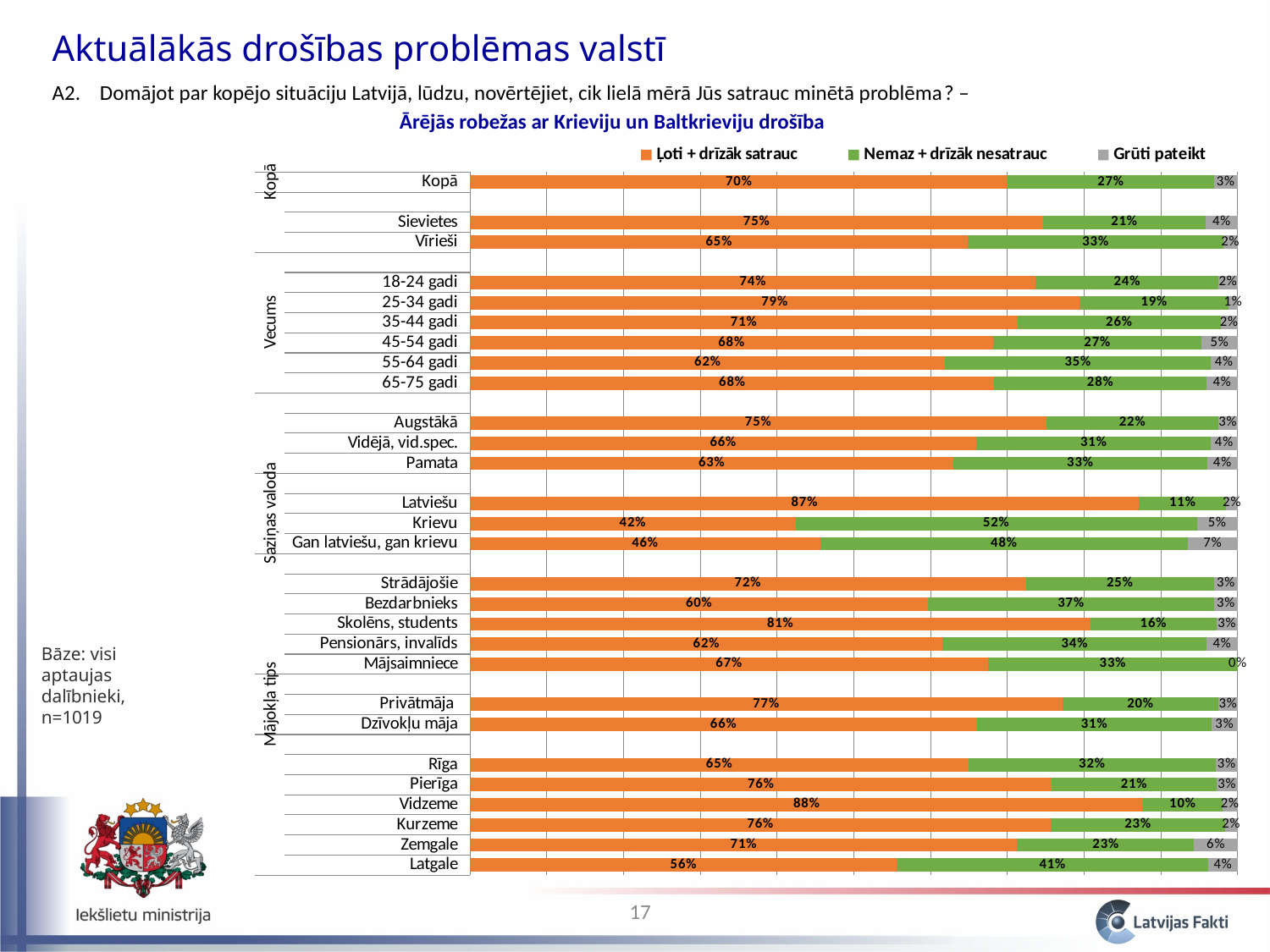
What is the difference between the "Ļoti + drīzāk satrauc" values for Sievietes and Vīrieši? 10% What kind of chart is shown on the slide? Stacked bar chart What is the value of "Grūti pateikt" for Gan latviešu, gan krievu? 7% How many series does the legend list? 3 Which has a larger "Nemaz + drīzāk nesatrauc" value, Latgale or Rīga? Latgale Which category has the lowest value for "Ļoti + drīzāk satrauc"? Krievu Which category has the highest value for "Ļoti + drīzāk satrauc"? Vidzeme What is the title of the chart? Ārējās robežas ar Krieviju un Baltkrieviju drošība What is the total of the stacked bar for Zemgale? 100% What is the value of "Ļoti + drīzāk satrauc" for Kopā? 70% What is the value of "Ļoti + drīzāk satrauc" for Skolēns, students? 81% What is the value of "Nemaz + drīzāk nesatrauc" for Krievu? 52%